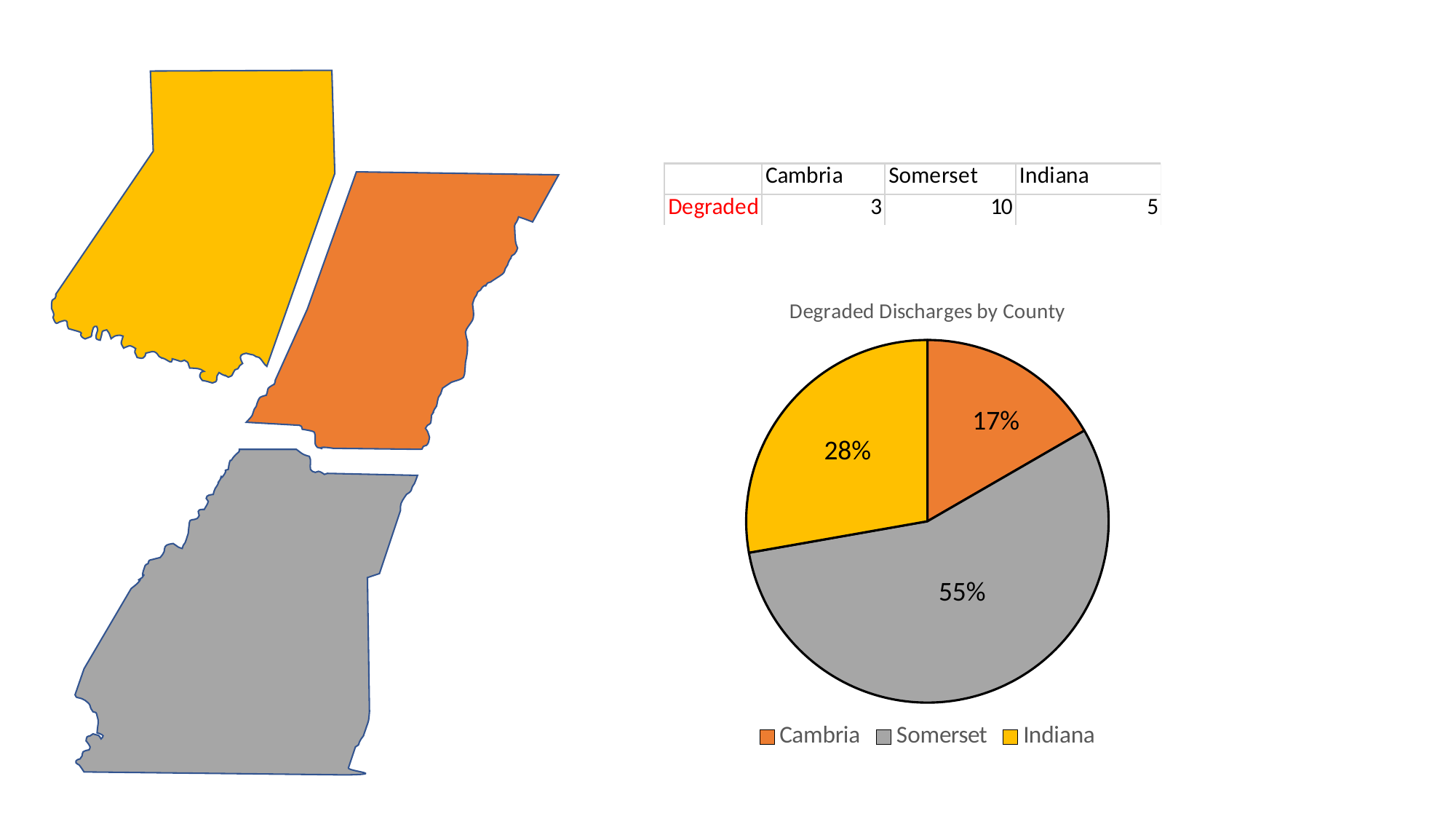
What is the title of the pie chart? Degraded Discharges by County What share of the pie does Somerset have? 55% What type of chart is shown on the slide? pie chart Which county has the smallest slice of the pie? Cambria What is the difference in percentage points between the Somerset and Indiana slices? 27 What share of the pie does Indiana have? 28% Which county has the largest slice of the pie? Somerset Which slice is larger, Indiana or Cambria? Indiana What colour is the Somerset slice in the pie chart? grey What share of the pie does Cambria have? 17% How many entries does the legend list? 3 How many slices does the pie chart have? 3